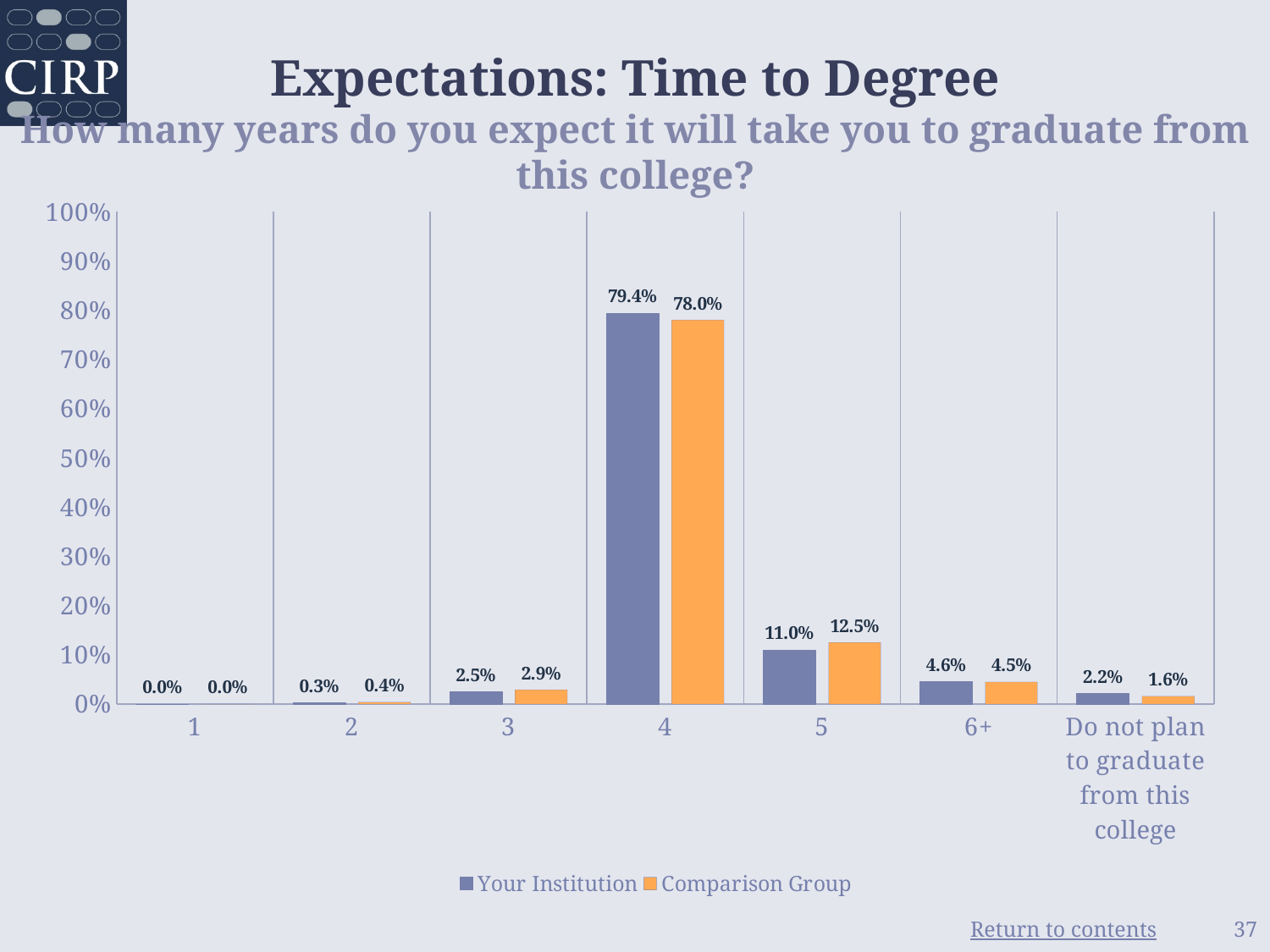
What is the value for Your Institution in the 4 years category? 79.4% How many series does the legend list? 2 How many categories are shown on the x axis? 7 What is the difference between Your Institution and Comparison Group in the 4 years category? 1.4% Is the value for Your Institution in the 4 years category greater or less than 70%? greater What is the value for Your Institution for 'Do not plan to graduate from this college'? 2.2% What is the value for Comparison Group in the 3 years category? 2.9% What is the value for Comparison Group in the 5 years category? 12.5% What kind of chart is shown on the slide? bar chart Which category has the highest value for Comparison Group? 4 Which is larger in the 5 years category, Your Institution or Comparison Group? Comparison Group Which series is shown in orange? Comparison Group